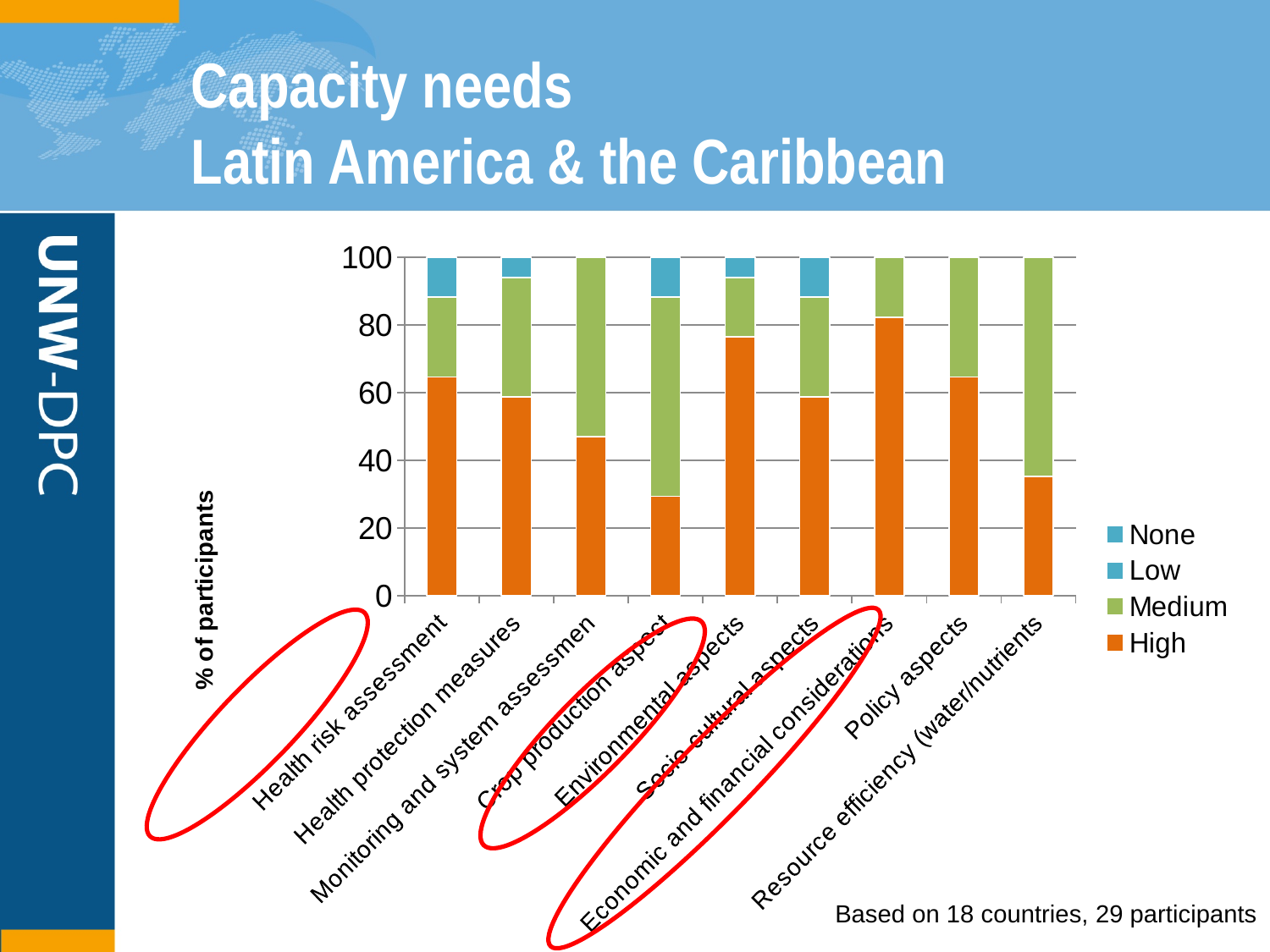
Is the High value for Resource efficiency (water/nutrients) greater or less than 40? less Is the High value for Health risk assessment greater or less than 60? greater Which category has the largest High share? Economic and financial considerations How many categories are shown on the x axis of the chart? 9 Which category has the smallest High share? Crop production aspect Is the High value for Crop production aspect greater or less than 40? less Which has the larger High share: Health risk assessment or Crop production aspect? Health risk assessment What kind of chart is shown on the slide? Stacked bar chart Which colour represents the High series in the legend? Orange What is the label on the vertical axis of the chart? % of participants How many series does the chart legend list? 4